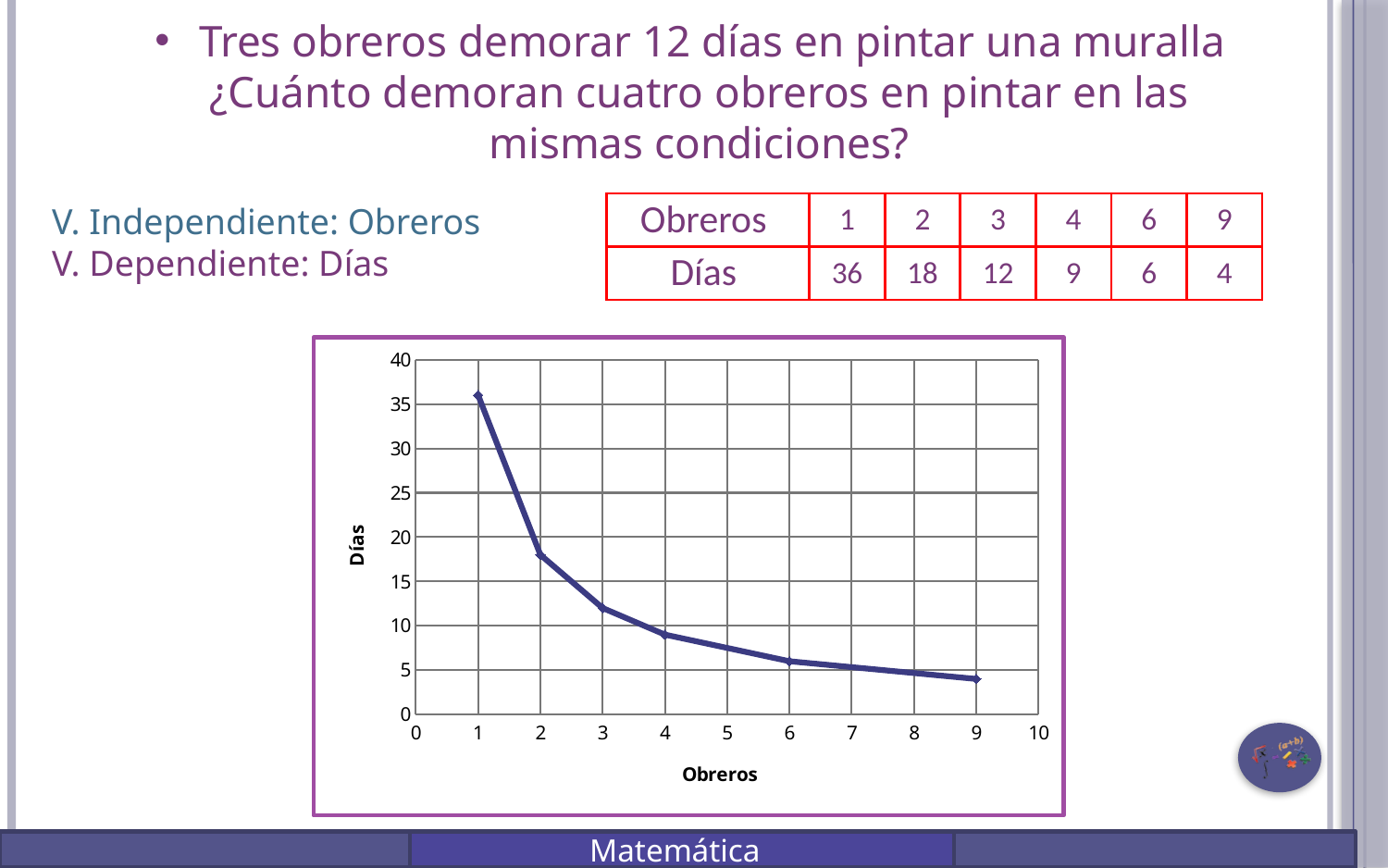
Do the values of Días rise or fall as Obreros increases along the x axis? fall What is the label on the vertical axis of the chart? Días At which number of Obreros is the value of Días highest? 1 How many data points are plotted on the chart? 6 Is the value of Días for 1 obrero greater or less than 30? greater Which has a larger value of Días: 3 obreros or 6 obreros? 3 obreros How many Días correspond to 1 obrero? 36 At which number of Obreros is the value of Días lowest? 9 How many Días correspond to 4 obreros? 9 Is the value of Días for 2 obreros greater or less than 20? less What kind of chart is shown on the slide? line chart What is the difference in Días between 1 obrero and 2 obreros? 18